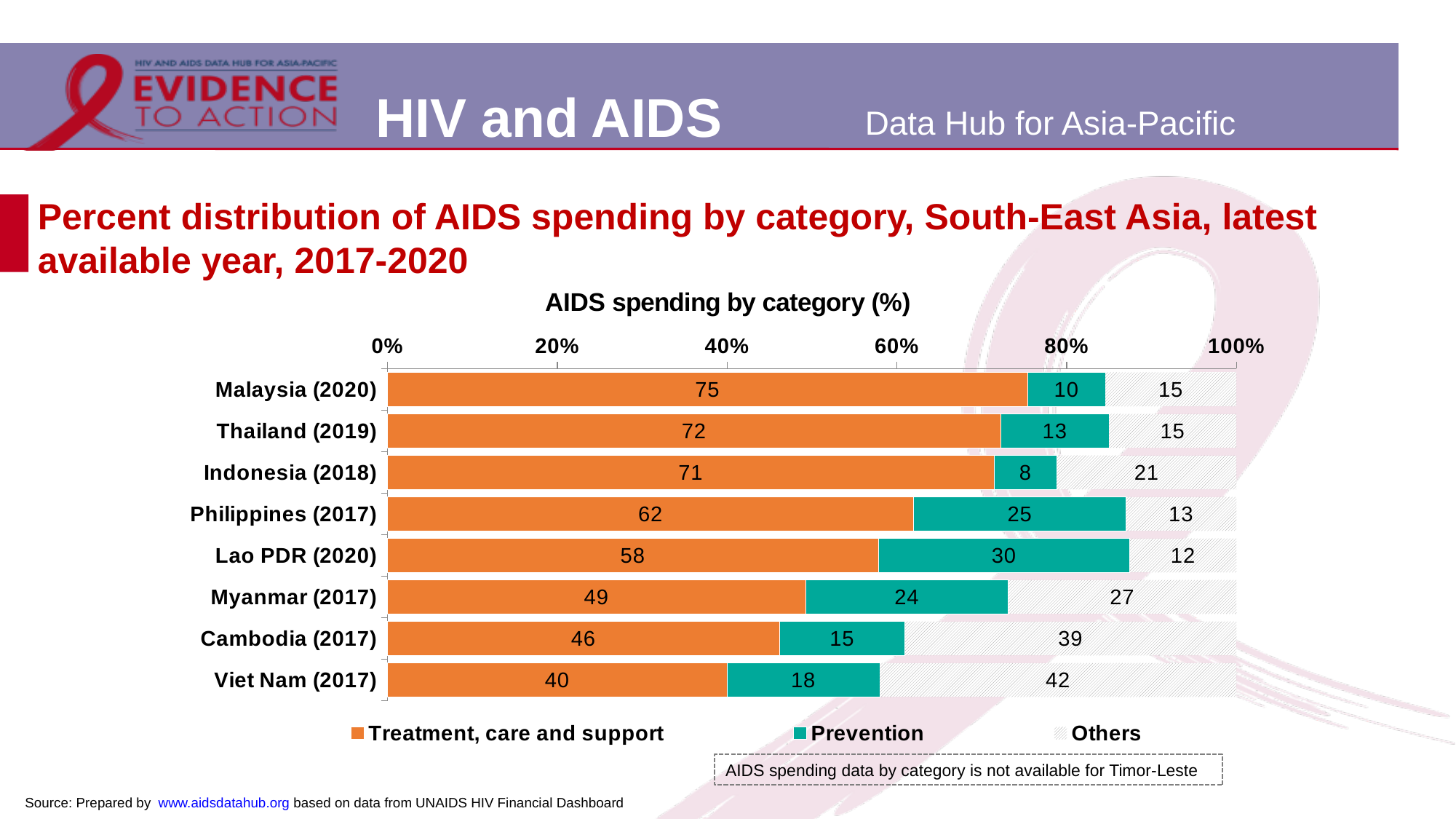
What is the Prevention value for Lao PDR (2020)? 30 What is the Treatment, care and support value for Malaysia (2020)? 75 What is the total of the stacked bar for Indonesia (2018)? 100 How many countries are shown on the chart? 8 What is the difference between the Others values for Cambodia (2017) and Myanmar (2017)? 12 Which is larger, the Prevention value for Philippines (2017) or for Thailand (2019)? Philippines (2017) Which country has the highest Treatment, care and support share? Malaysia (2020) How many series does the legend list? 3 What is the Others value for Viet Nam (2017)? 42 What kind of chart is shown? Stacked bar chart Which series is shown in orange? Treatment, care and support Which country has the lowest Prevention share? Indonesia (2018)